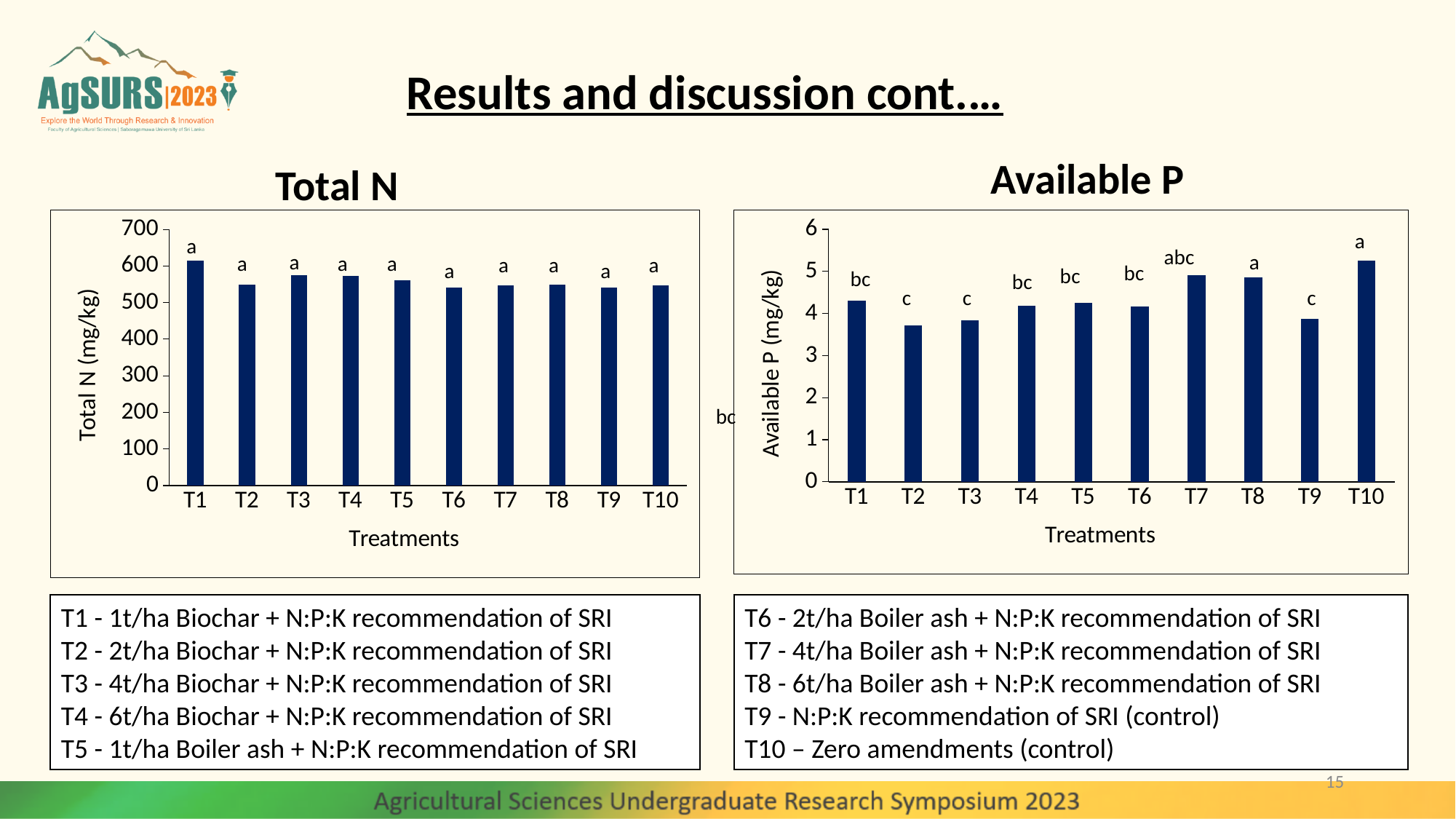
In the Total N chart, which treatment has the highest Total N? T1 In the Total N chart, is the value for T1 greater or less than 600? greater How many treatments are plotted in the Total N chart? 10 In the Available P chart, is the value for T2 greater or less than 4? less In the Available P chart, which treatment has the highest Available P? T10 In the Available P chart, what is the y-axis title? Available P (mg/kg) In the Available P chart, which is larger, the value for T7 or the value for T2? T7 In the Available P chart, is the value for T10 greater or less than 5? greater In the Available P chart, what letter label is shown above the T7 bar? abc What kind of chart is the Available P chart? bar chart